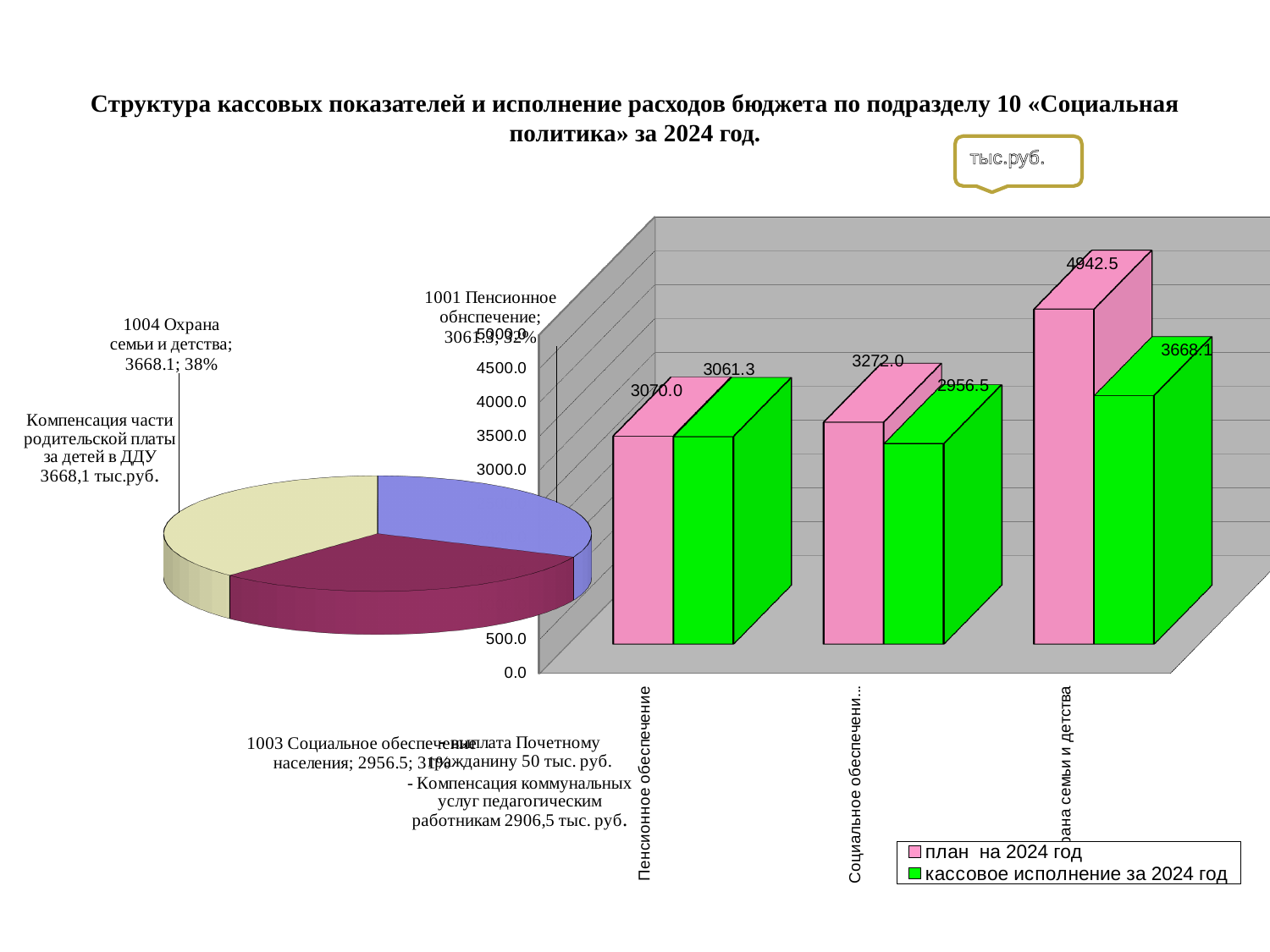
In the bar chart, what is the value of план на 2024 год for Пенсионное обеспечение? 3070.0 What kind of chart is the chart on the right side of the slide? bar chart In the bar chart, what is the difference between план на 2024 год and кассовое исполнение за 2024 год for Социальное обеспечение? 315.5 In the bar chart, what is the value of кассовое исполнение за 2024 год for Социальное обеспечение? 2956.5 In the bar chart, which category has the highest план на 2024 год value? Охрана семьи и детства In the bar chart, what is the value of план на 2024 год for Охрана семьи и детства? 4942.5 In the bar chart, which has the larger план на 2024 год value: Социальное обеспечение or Пенсионное обеспечение? Социальное обеспечение How many series does the legend of the bar chart list? 2 In the pie chart, what share does 1004 Охрана семьи и детства have? 38% How many categories are shown on the x axis of the bar chart? 3 In the bar chart, what is the value of кассовое исполнение за 2024 год for Охрана семьи и детства? 3668.1 In the bar chart, what is the difference between план на 2024 год and кассовое исполнение за 2024 год for Охрана семьи и детства? 1274.4